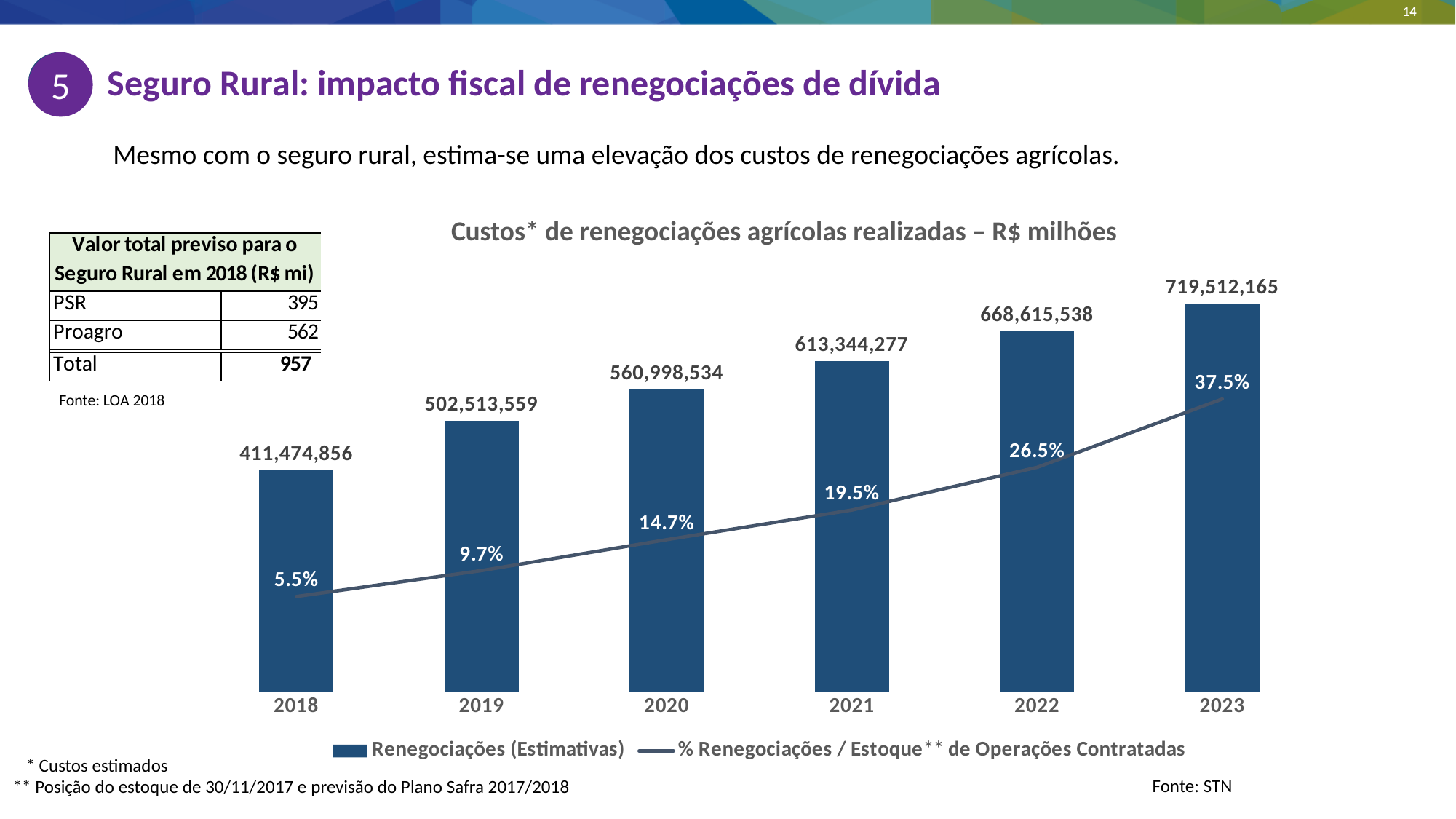
By how many percentage points does the % Renegociações / Estoque value for 2023 exceed that for 2022? 11.0 percentage points Do the Renegociações (Estimativas) values rise or fall from 2018 to 2023? rise How many years are shown on the x axis of the chart? 6 Which is larger, the Renegociações (Estimativas) value for 2019 or for 2020? 2020 What is the % Renegociações / Estoque de Operações Contratadas for 2022? 26.5% Which year has the lowest % Renegociações / Estoque de Operações Contratadas? 2018 How many series does the chart legend list? 2 What is the % Renegociações / Estoque de Operações Contratadas for 2020? 14.7% Which year has the highest value of Renegociações (Estimativas)? 2023 What is the difference between the Renegociações (Estimativas) values for 2023 and 2018? 308,037,309 What is the value of Renegociações (Estimativas) for 2018? 411,474,856 What is the value of Renegociações (Estimativas) for 2021? 613,344,277